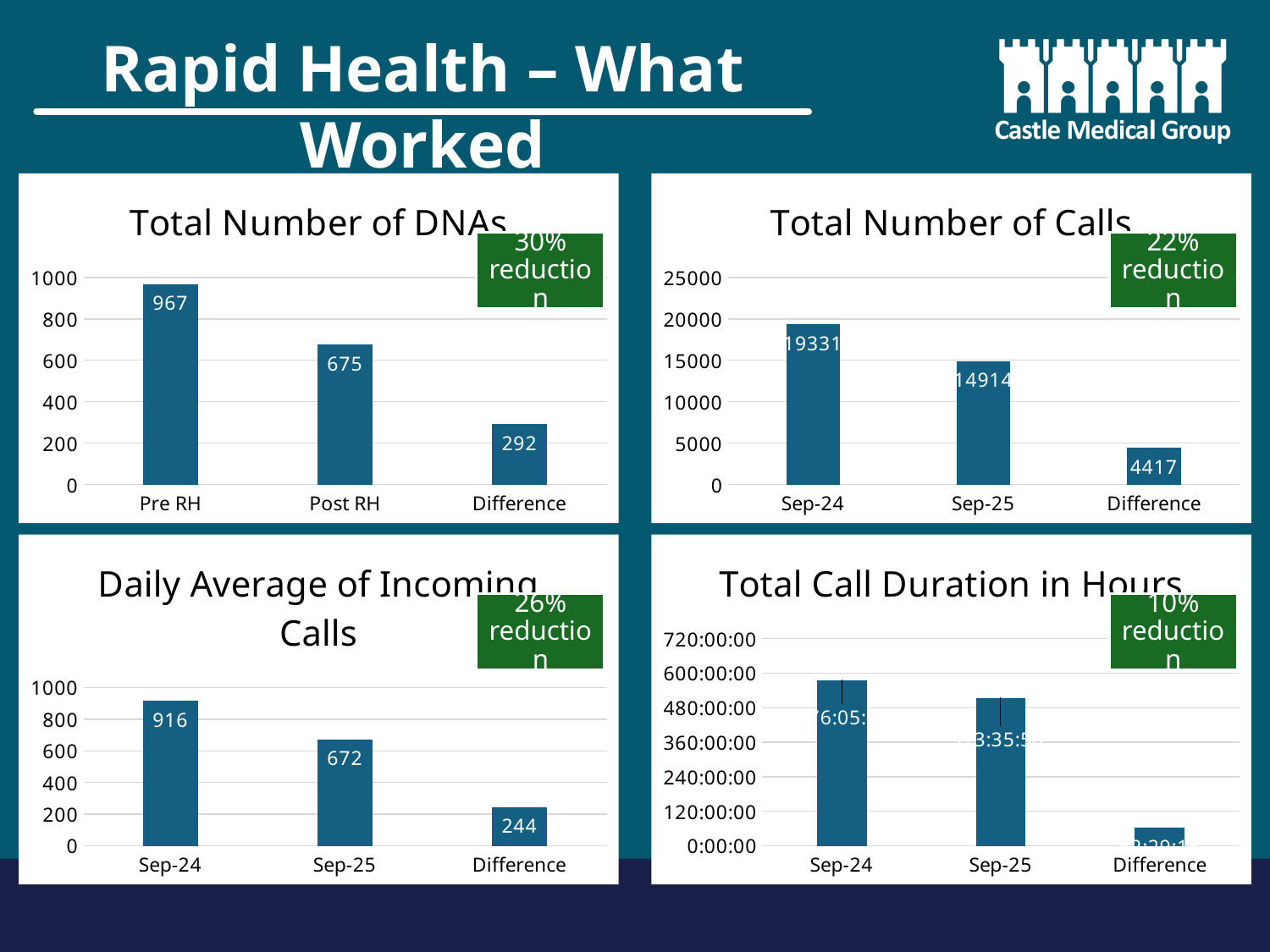
In the Daily Average of Incoming Calls chart, which is larger, the value for Sep-24 or Sep-25? Sep-24 In the Total Number of DNAs chart, what is the value for Pre RH? 967 In the Total Number of DNAs chart, what is the value for Post RH? 675 In the Total Call Duration in Hours chart, is the value for Difference greater or less than 120:00:00? less In the Total Number of Calls chart, what is the value for Sep-25? 14914 In the Daily Average of Incoming Calls chart, what is the value for Sep-24? 916 In the Total Call Duration in Hours chart, is the value for Sep-24 greater or less than 480:00:00? greater In the Daily Average of Incoming Calls chart, what is the value for Difference? 244 What kind of chart is the Total Number of DNAs chart? bar chart In the Total Number of Calls chart, which category has the lowest value? Difference In the Total Number of DNAs chart, what is the difference between the Pre RH and Post RH values? 292 In the Total Number of Calls chart, what is the value for Sep-24? 19331